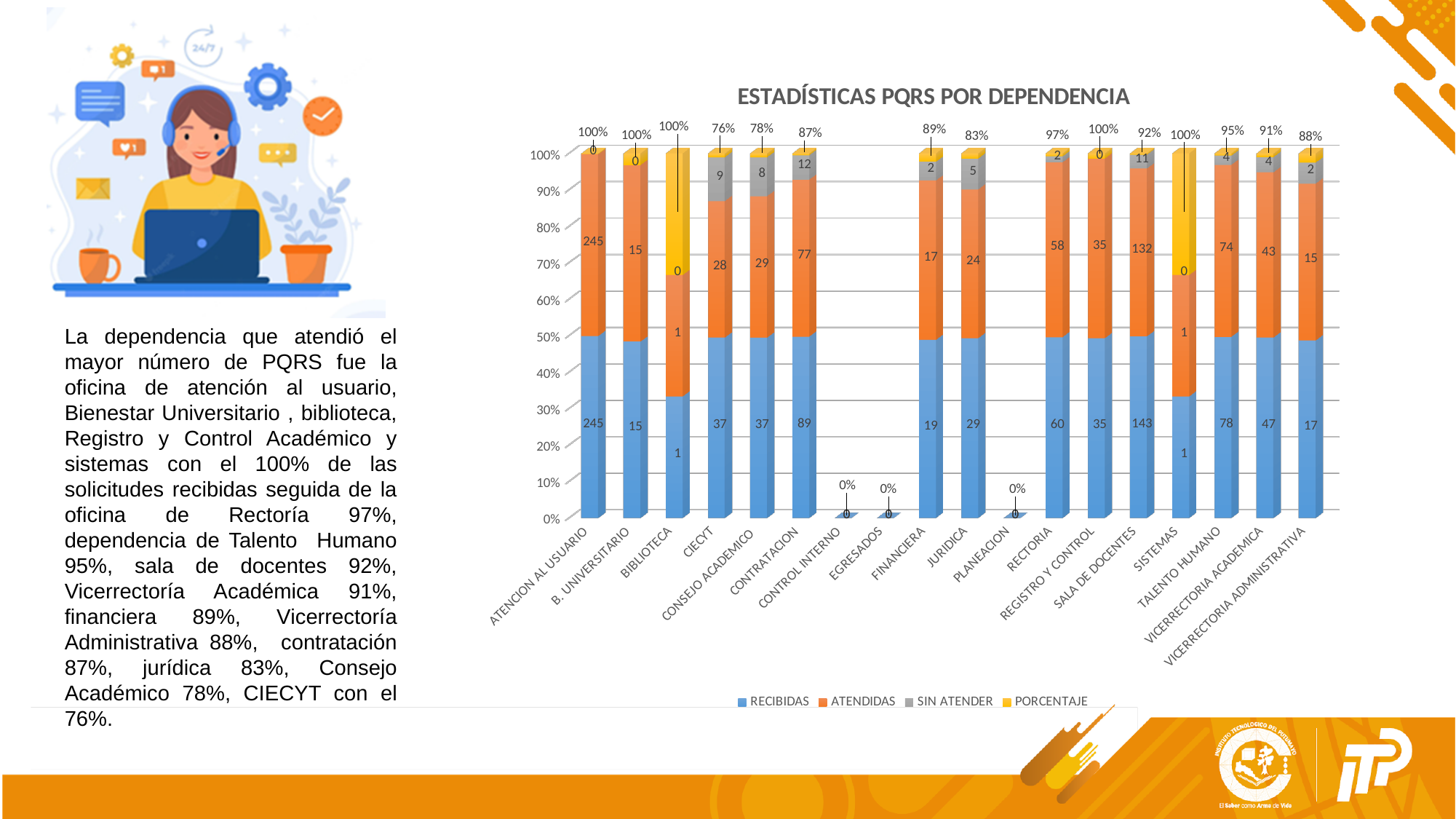
What is the title of the chart? ESTADÍSTICAS PQRS POR DEPENDENCIA Which has a larger RECIBIDAS value, TALENTO HUMANO or RECTORIA? TALENTO HUMANO How many dependencias (categories) are shown on the x axis of the chart? 18 What PORCENTAJE is shown for CIECYT? 76% What is the ATENDIDAS value for SALA DE DOCENTES? 132 How many series does the chart legend list? 4 What is the RECIBIDAS value for ATENCION AL USUARIO? 245 Which dependencia has the highest RECIBIDAS value? ATENCION AL USUARIO What kind of chart is shown on the slide? Stacked bar chart What is the difference between the RECIBIDAS and ATENDIDAS values for CONTRATACION? 12 What PORCENTAJE is shown for CONTROL INTERNO? 0% What is the SIN ATENDER value for CONTRATACION? 12